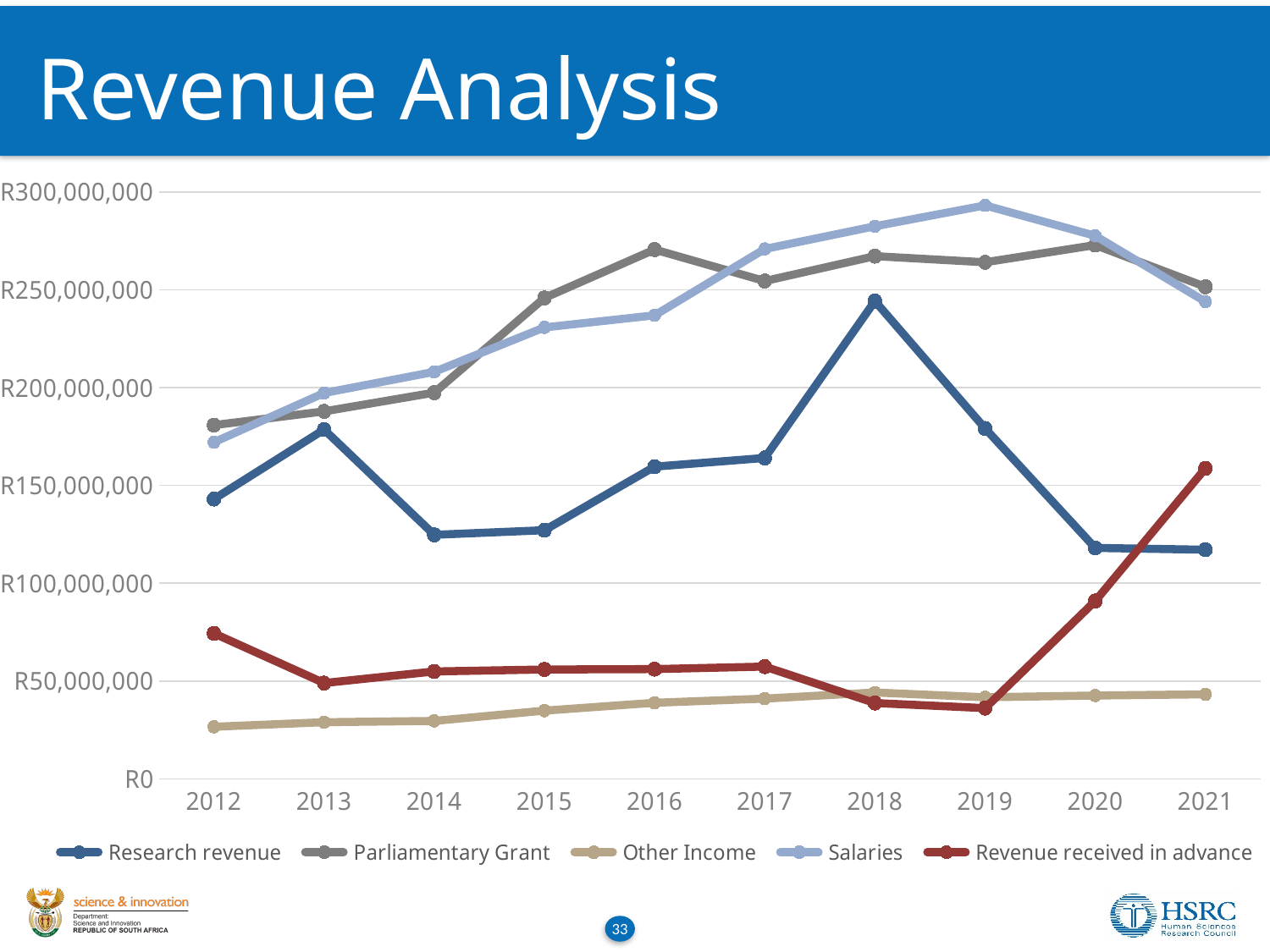
Is the value for Parliamentary Grant in 2012 greater or less than R200,000,000? less Which series has the lowest value in 2021? Other Income What kind of chart is shown on the slide? Line chart In which year is Research revenue at its highest? 2018 How many series does the legend list? 5 In which year is Other Income at its lowest? 2012 Is the value for Revenue received in advance in 2021 greater or less than R100,000,000? greater How many years are shown on the x axis? 10 Is the value for Research revenue in 2018 greater or less than R200,000,000? greater In 2019, which is larger: Salaries or Parliamentary Grant? Salaries In which year is Salaries at its highest? 2019 Does Other Income generally rise or fall from 2012 to 2021? Rise